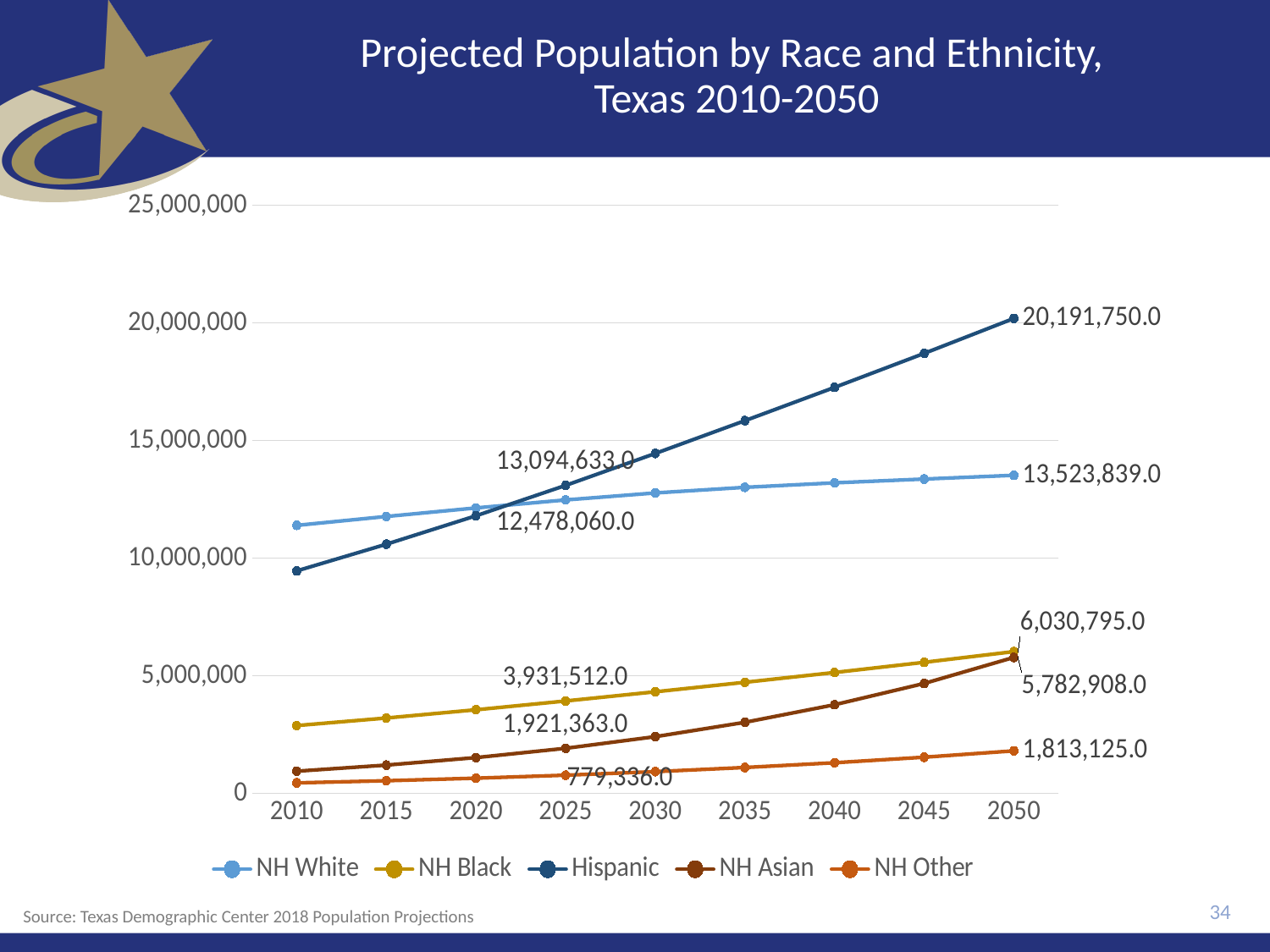
Which group has the highest projected population in 2050? Hispanic What type of chart is shown on the slide? Line chart What is the projected NH Other population in 2050? 1,813,125.0 Which group has the lowest projected population in 2025? NH Other What is the projected NH Asian population in 2025? 1,921,363.0 What is the projected NH White population in 2025? 12,478,060.0 Does the Hispanic line rise or fall from 2010 to 2050? Rises What is the projected Hispanic population in 2050? 20,191,750.0 How many years are plotted along the x axis? 9 How many series does the legend list? 5 Is the Hispanic population in 2010 greater or less than 10,000,000? less What is the difference between the Hispanic and NH White projected populations in 2050? 6,667,911.0